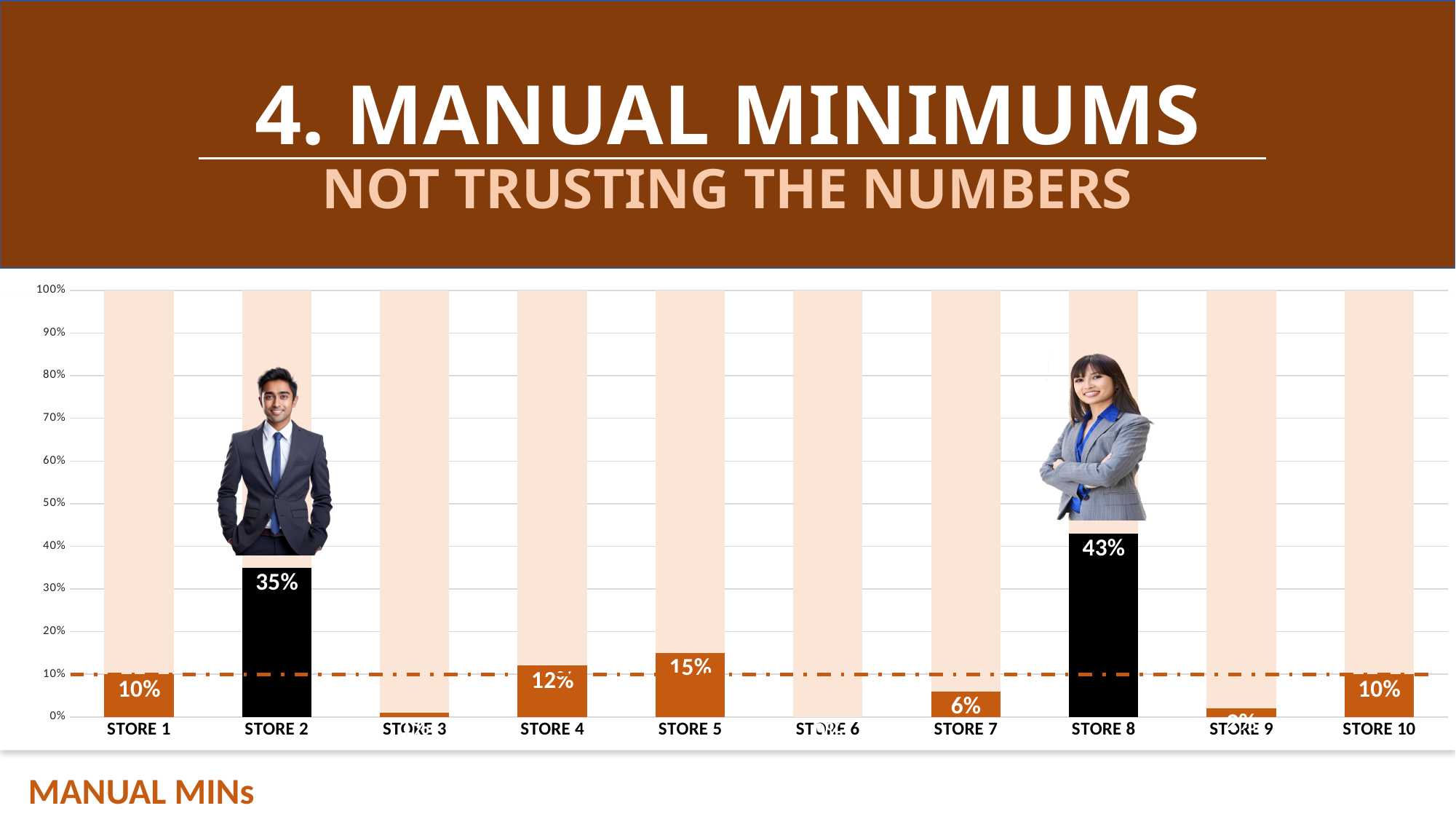
What is the difference between the values for Store 8 and Store 2? 8% What is the difference between the values for Store 5 and Store 4? 3% What kind of chart is shown on the slide? bar chart Is the value for Store 3 greater or less than 10%? less What is the value for Store 2? 35% How many stores are shown on the x axis? 10 What is the value for Store 8? 43% What is the value for Store 5? 15% Which store has the highest value? Store 8 Which has the larger value, Store 4 or Store 5? Store 5 At what level on the y axis is the dashed horizontal line drawn? 10% What is the value for Store 7? 6%